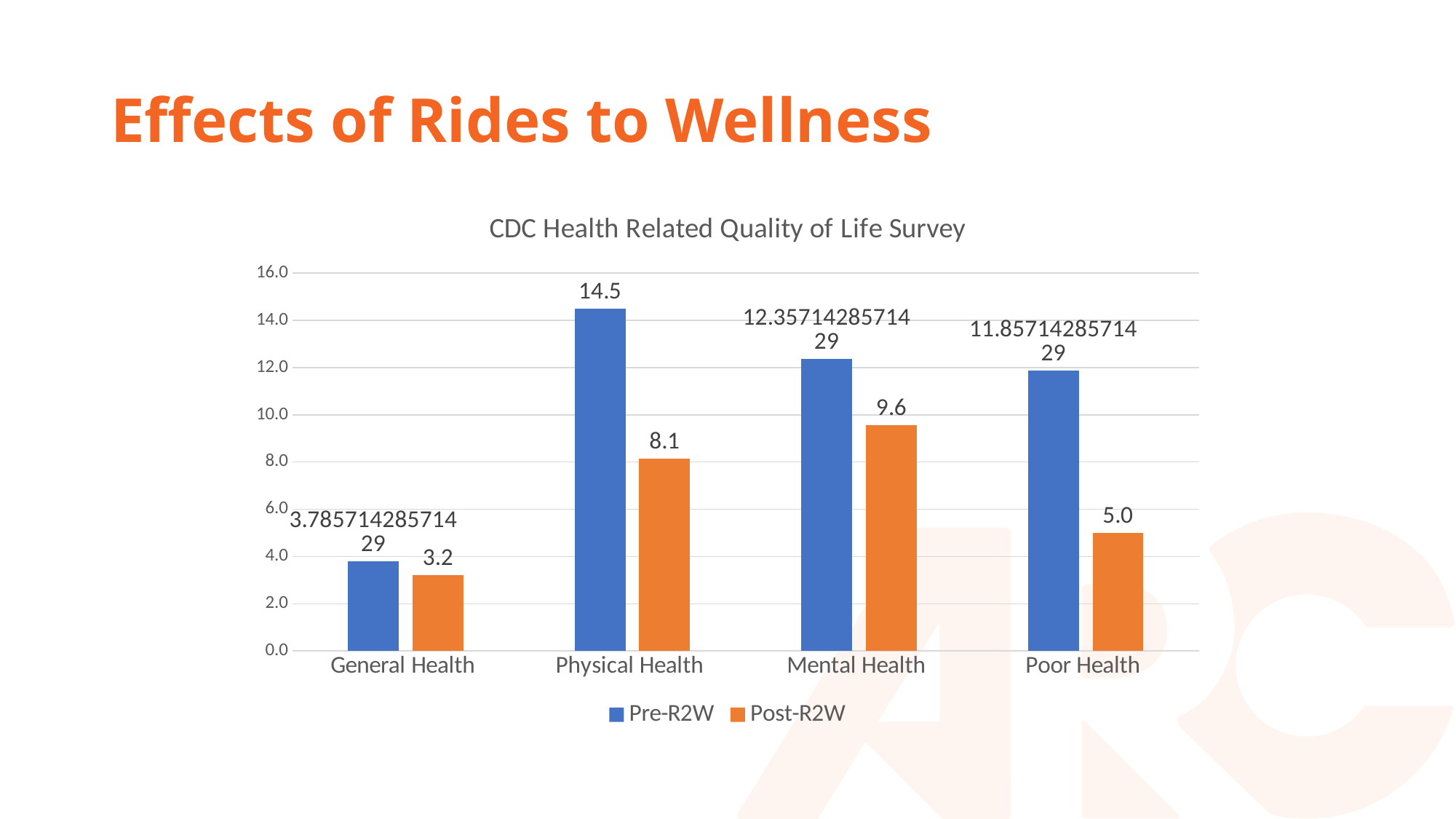
How many categories are shown on the x axis? 4 Which category has the highest Pre-R2W value? Physical Health What is the Post-R2W value for Physical Health? 8.1 Which is larger for Mental Health, the Pre-R2W value or the Post-R2W value? Pre-R2W Which category has the lowest Post-R2W value? General Health What is the Pre-R2W value for Physical Health? 14.5 What is the Post-R2W value for Mental Health? 9.6 What is the Post-R2W value for Poor Health? 5.0 Is the Pre-R2W value for Poor Health greater or less than 10.0? greater What is the title of the chart? CDC Health Related Quality of Life Survey What is the difference between the Pre-R2W and Post-R2W values for Physical Health? 6.4 How many series does the legend list? 2